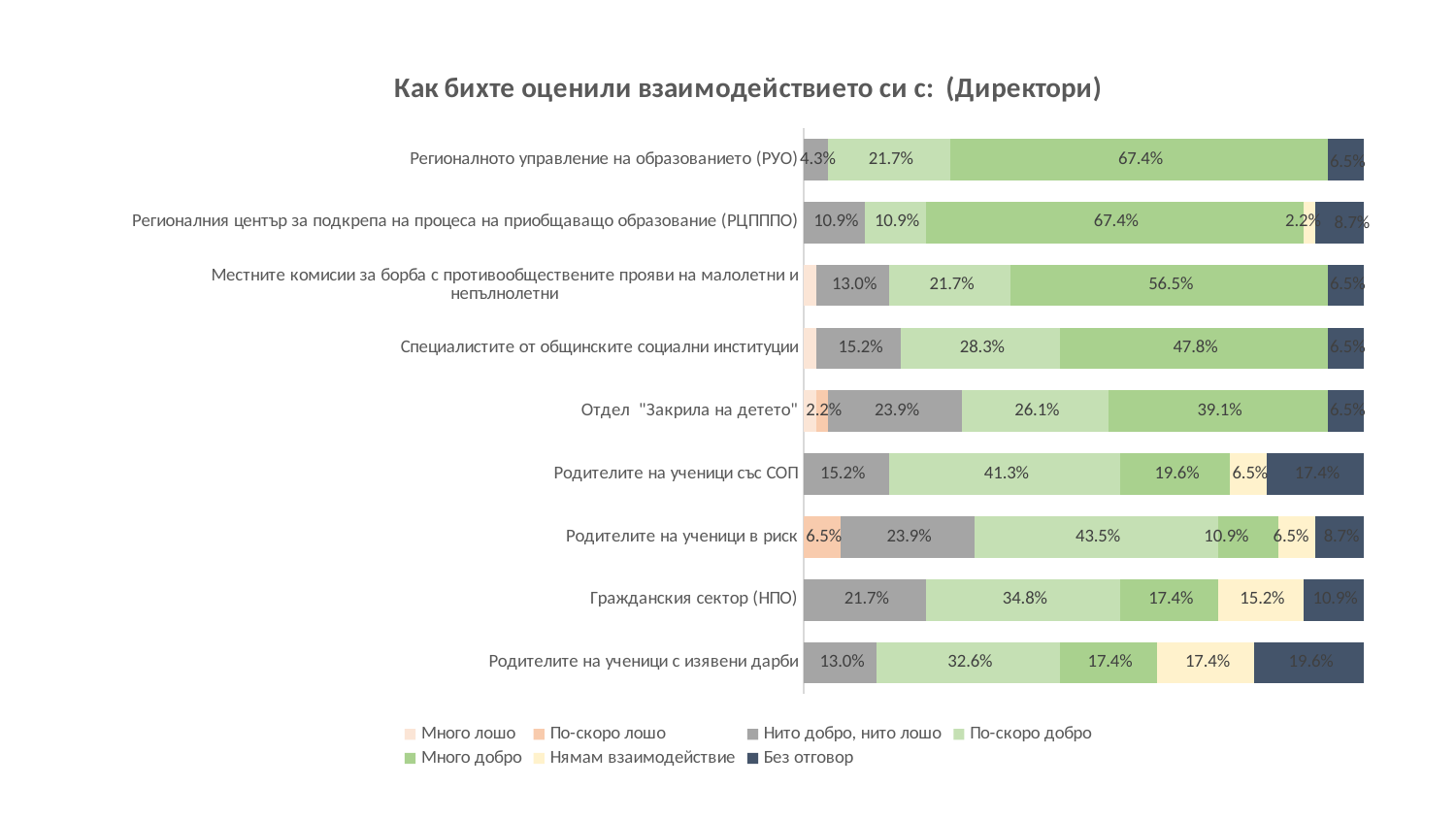
What is the "По-скоро добро" value for "Родителите на ученици със СОП"? 41.3% What is the difference between the "Много добро" values for "Местните комисии за борба с противообществените прояви на малолетни и непълнолетни" and "Специалистите от общинските социални институции"? 8.7% How many series does the legend list? 7 What is the "Много добро" value for "Регионалното управление на образованието (РУО)"? 67.4% How many categories (rows) does the chart show? 9 Which is larger: the "Нито добро, нито лошо" value for "Отдел "Закрила на детето"" or for "Гражданския сектор (НПО)"? Отдел "Закрила на детето" Which category has the highest "Без отговор" value? Родителите на ученици с изявени дарби What is the "Нямам взаимодействие" value for "Гражданския сектор (НПО)"? 15.2% What kind of chart is shown on the slide? Stacked bar chart What is the title of the chart? Как бихте оценили взаимодействието си с: (Директори) What is the "Без отговор" value for "Родителите на ученици с изявени дарби"? 19.6% Which category has the lowest "Много добро" value? Родителите на ученици в риск